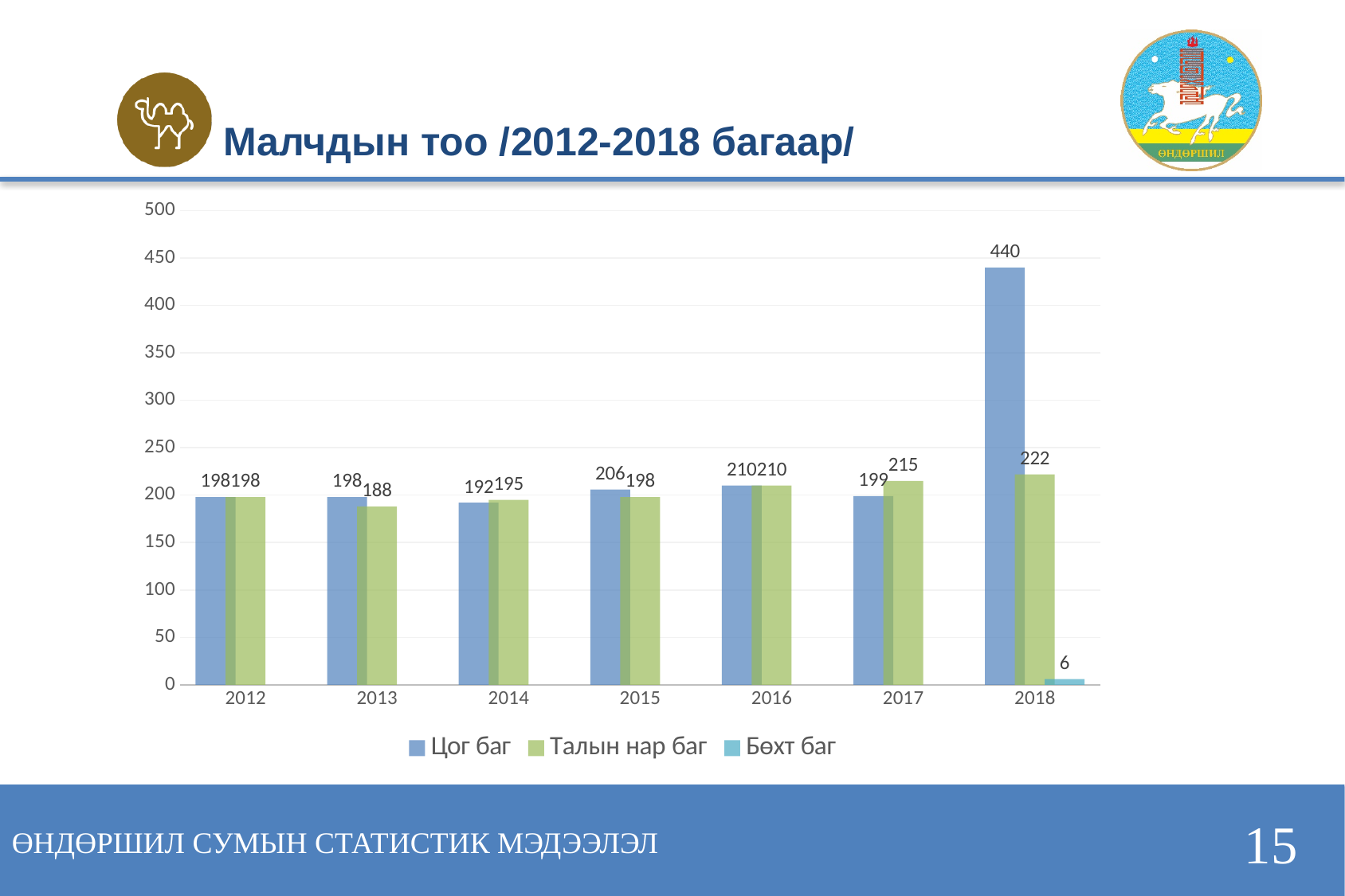
What is the value for Цог баг in 2018? 440 How many years are shown on the x axis? 7 What is the value for Талын нар баг in 2013? 188 What is the value for Талын нар баг in 2017? 215 In which year is the value for Цог баг highest? 2018 Which is larger in 2017, Цог баг or Талын нар баг? Талын нар баг In which year is the value for Талын нар баг lowest? 2013 What is the difference between Цог баг and Талын нар баг in 2018? 218 What kind of chart is shown on the slide? bar chart What is the value for Бөхт баг in 2018? 6 How many series does the legend list? 3 What is the title of the chart on the slide? Малчдын тоо /2012-2018 багаар/